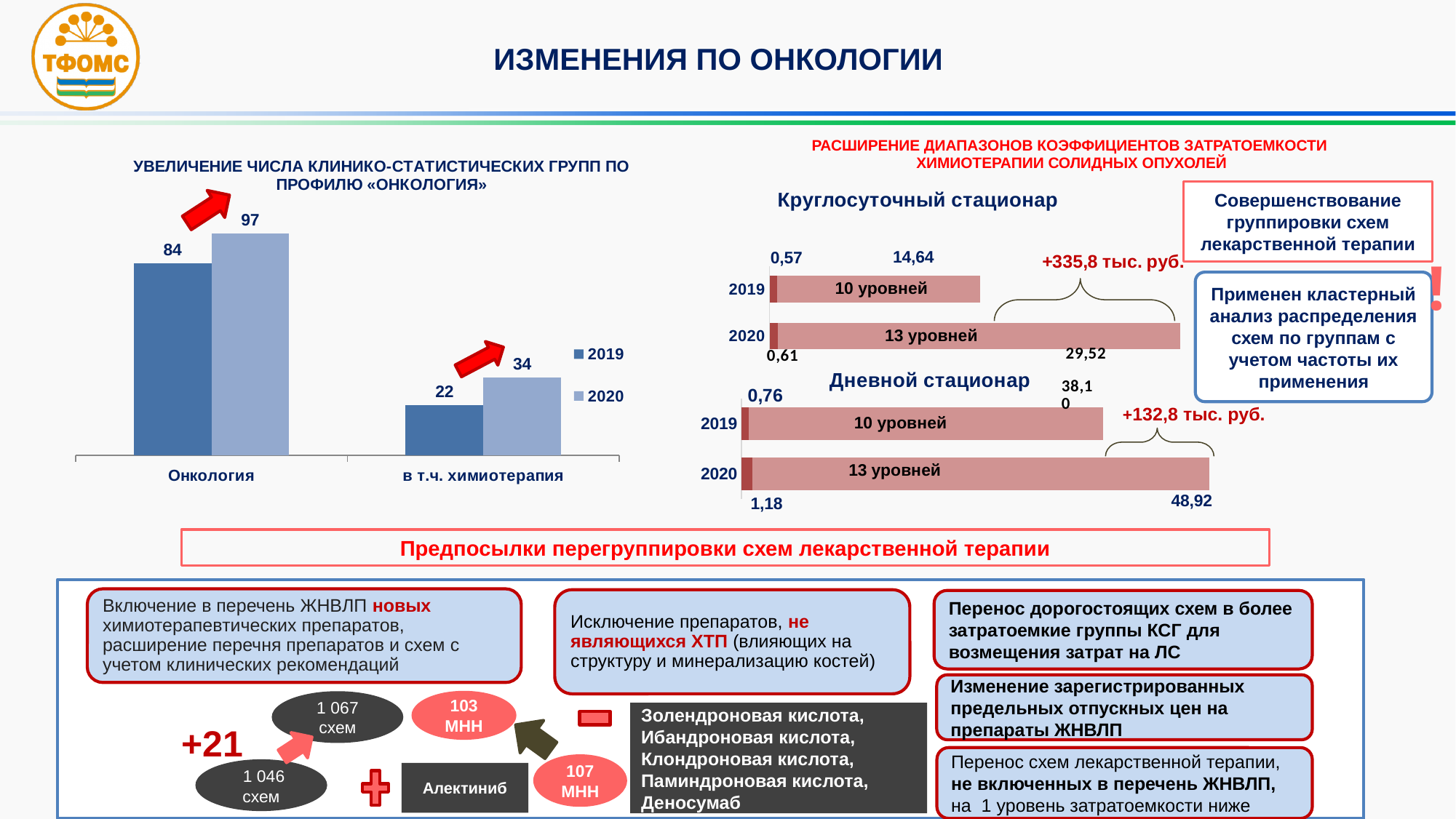
In the chart 'Увеличение числа клинико-статистических групп по профилю «Онкология»', what is the value for в т.ч. химиотерапия in 2019? 22 In the 'Круглосуточный стационар' chart, what is the lower value of the 2019 bar? 0,57 In the 'Дневной стационар' chart, what is the upper value of the 2020 bar? 48,92 In the 'Дневной стационар' chart, how many levels (уровней) are labelled on the 2020 bar? 13 уровней In the 'Круглосуточный стационар' chart, what is the upper value of the 2020 bar? 29,52 In the chart 'Увеличение числа клинико-статистических групп по профилю «Онкология»', what is the difference between the 2020 and 2019 values for в т.ч. химиотерапия? 12 In the chart 'Увеличение числа клинико-статистических групп по профилю «Онкология»', what is the difference between the 2020 and 2019 values for Онкология? 13 In the chart 'Увеличение числа клинико-статистических групп по профилю «Онкология»', what is the value for Онкология in 2020? 97 What kind of chart is 'Увеличение числа клинико-статистических групп по профилю «Онкология»'? Bar chart How many series does the legend of the chart 'Увеличение числа клинико-статистических групп по профилю «Онкология»' list? 2 In the chart 'Увеличение числа клинико-статистических групп по профилю «Онкология»', which is larger: the 2019 value for Онкология or the 2020 value for в т.ч. химиотерапия? 2019 value for Онкология How many categories are shown on the x axis of the chart 'Увеличение числа клинико-статистических групп по профилю «Онкология»'? 2